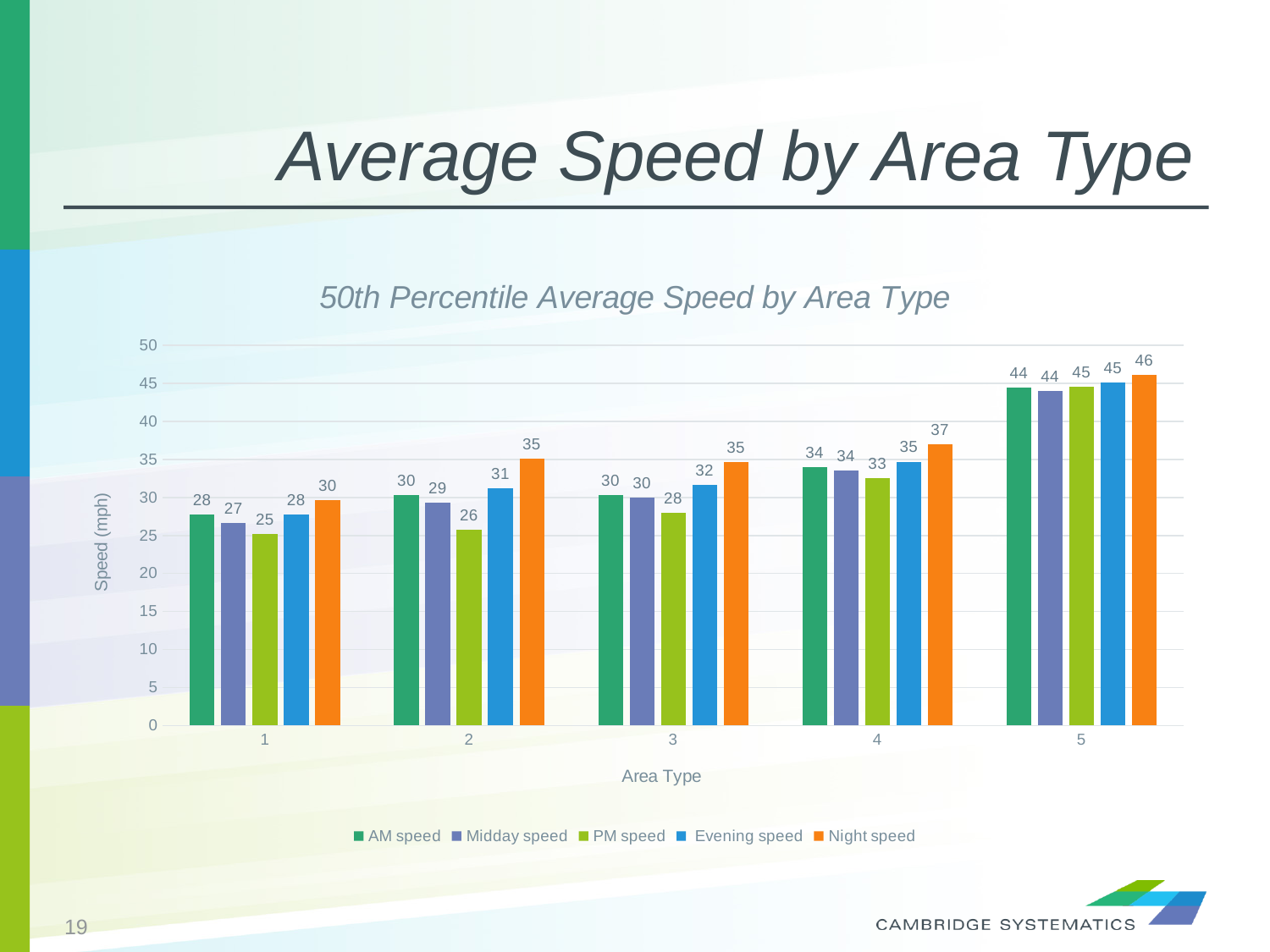
Is the Midday speed for Area Type 1 greater or less than 30? less What is the label of the y axis? Speed (mph) Which is larger for Area Type 4: the Night speed or the AM speed? Night speed What is the difference between the Night speed and the PM speed for Area Type 2? 9 What is the Evening speed for Area Type 3? 32 What is the PM speed for Area Type 2? 26 What kind of chart is shown on the slide? bar chart Which area type has the lowest PM speed? 1 How many area types are shown on the x axis? 5 What is the Night speed for Area Type 5? 46 Which area type has the highest AM speed? 5 How many series does the legend list? 5